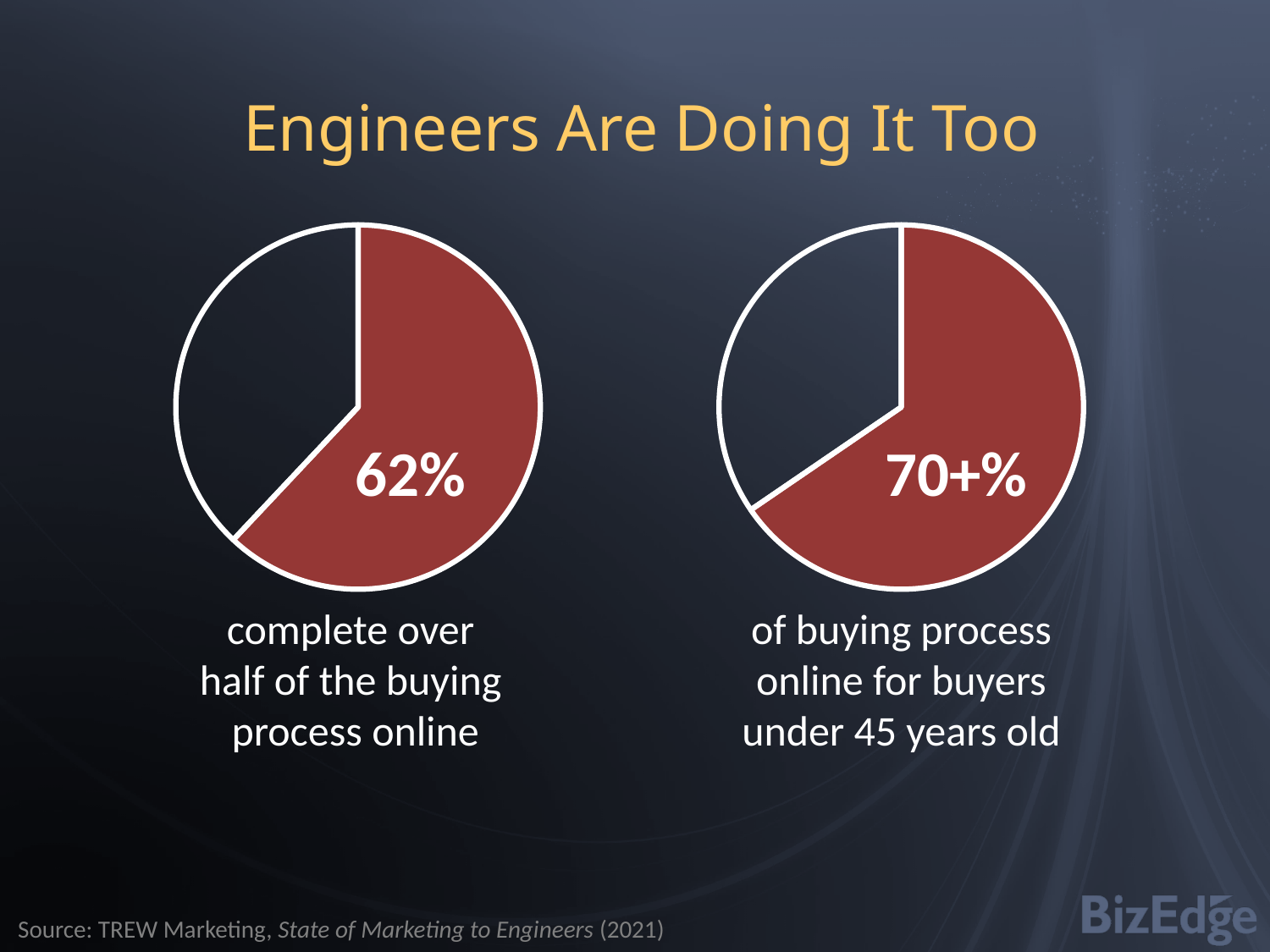
What is the title of the slide containing the two pie charts? Engineers Are Doing It Too On the left pie chart, what percentage of engineers complete over half of the buying process online? 62% On the right pie chart, what share of the buying process is done online for buyers under 45 years old? 70+% How many slices does the right pie chart have? 2 Which pie chart shows the larger highlighted share, the left one (62%) or the right one (70+%)? The right one (70+%) What kind of chart is used on the left side of the slide? Pie chart How many pie charts are shown on the slide? 2 What colour is the highlighted slice in both pie charts? Red What kind of chart is used on the right side of the slide? Pie chart On the left pie chart, what share of the pie does the highlighted red slice represent? 62% How many slices does the left pie chart have? 2